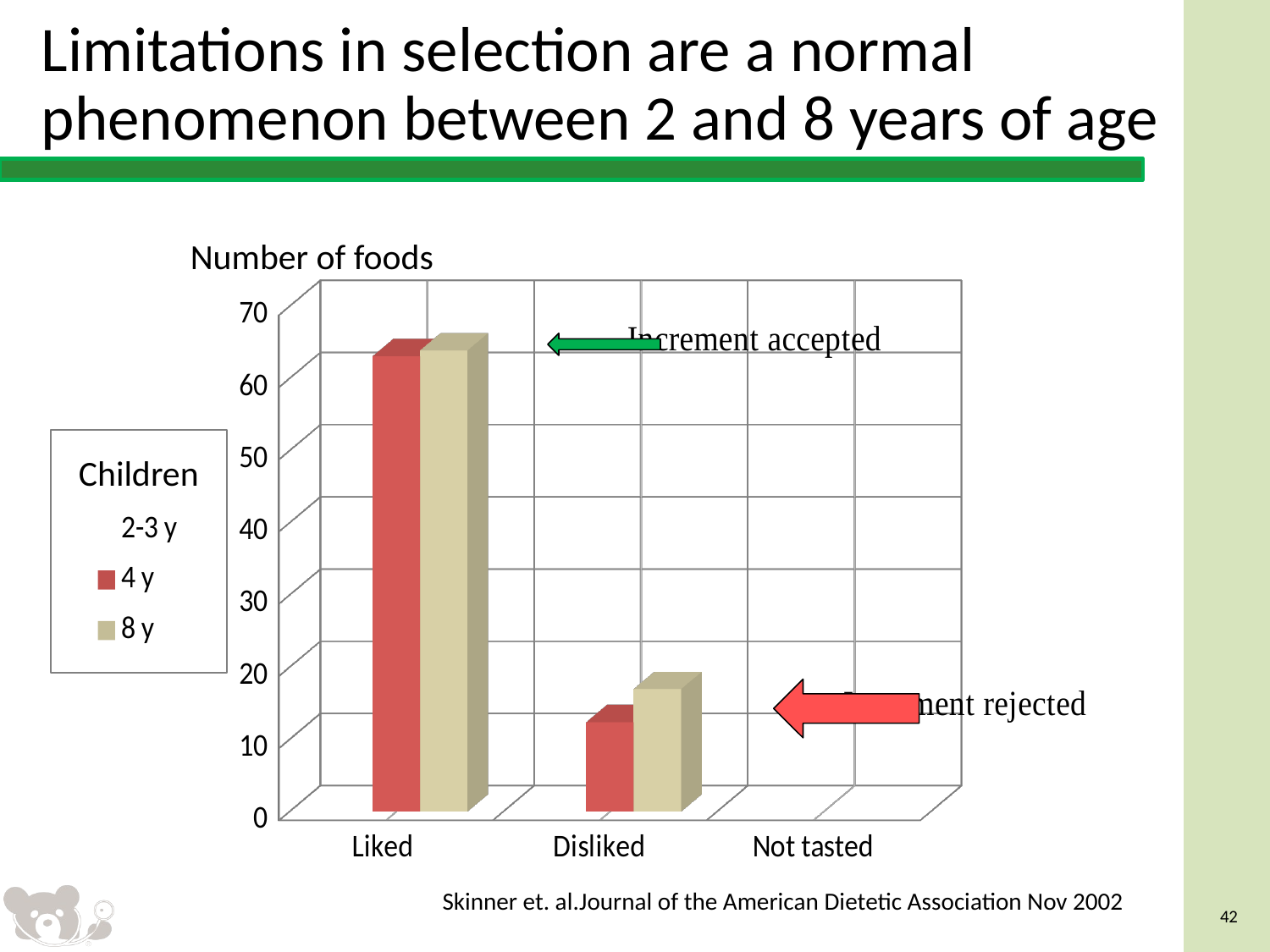
How many categories are shown on the x axis of the chart? 3 Which category has the highest bars in the chart? Liked Is the value for Liked foods among 4 y children greater or less than 50? greater For 4 y children, which is larger: the number of Liked foods or the number of Disliked foods? Liked What is the title of the chart legend? Children Is the value for Liked foods among 8 y children greater or less than 40? greater How many age groups does the chart legend list? 3 Is the value for Disliked foods among 8 y children greater or less than 20? less What kind of chart is shown on the slide? bar chart What is the label on the vertical axis of the chart? Number of foods For Disliked foods, which age group has the larger value: 4 y or 8 y? 8 y